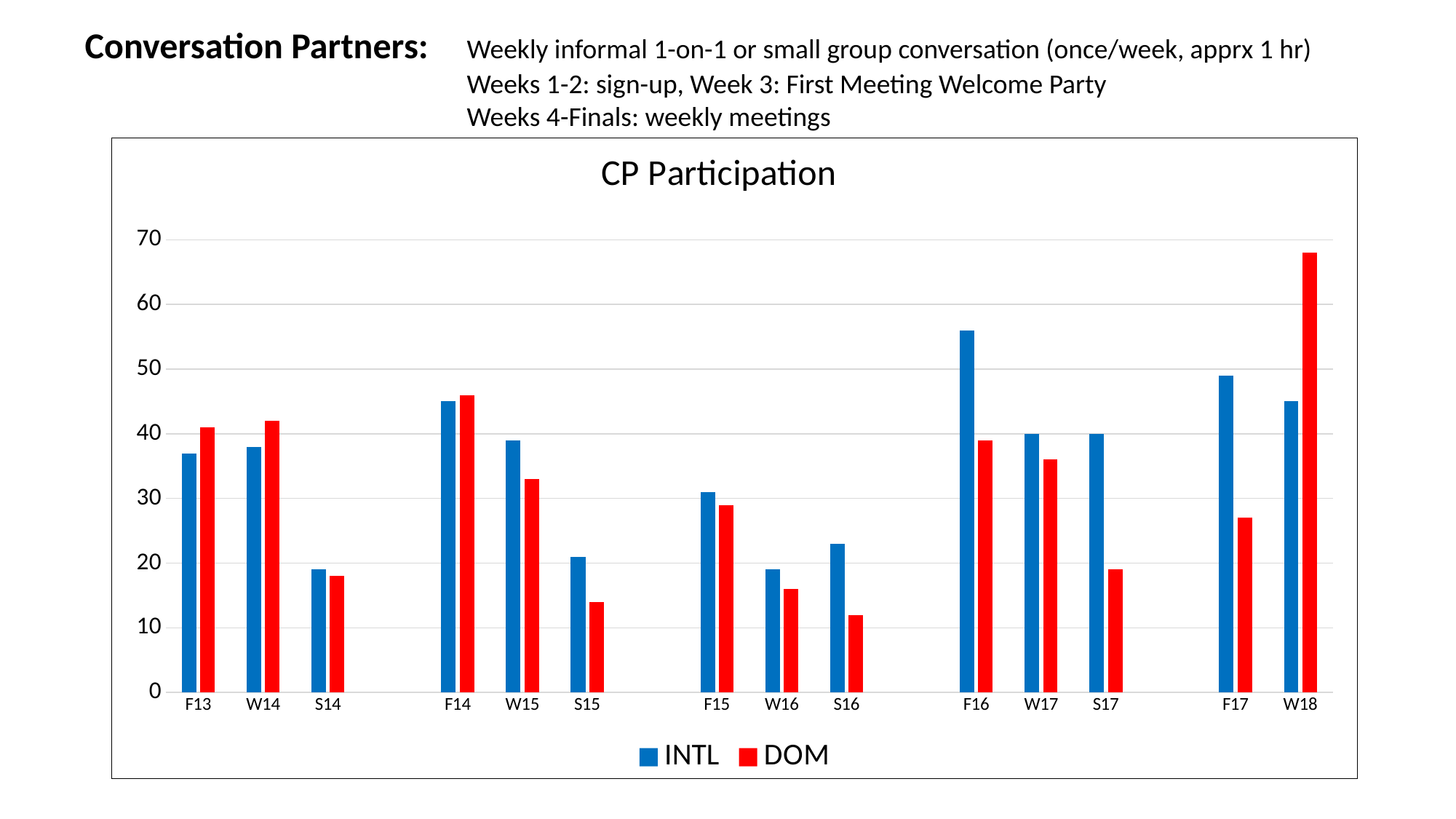
How many categories (terms) are shown on the x axis? 14 What is the title of the chart? CP Participation What kind of chart is shown on the slide? bar chart Is the INTL value for F16 greater or less than 50? greater For W18, which is larger, INTL or DOM? DOM How many series does the legend list? 2 Is the DOM value for W18 greater or less than 60? greater Is the DOM value for S16 greater or less than 20? less Which category has the highest INTL value? F16 Which category has the highest DOM value? W18 For F17, which is larger, INTL or DOM? INTL Which category has the lowest DOM value? S16